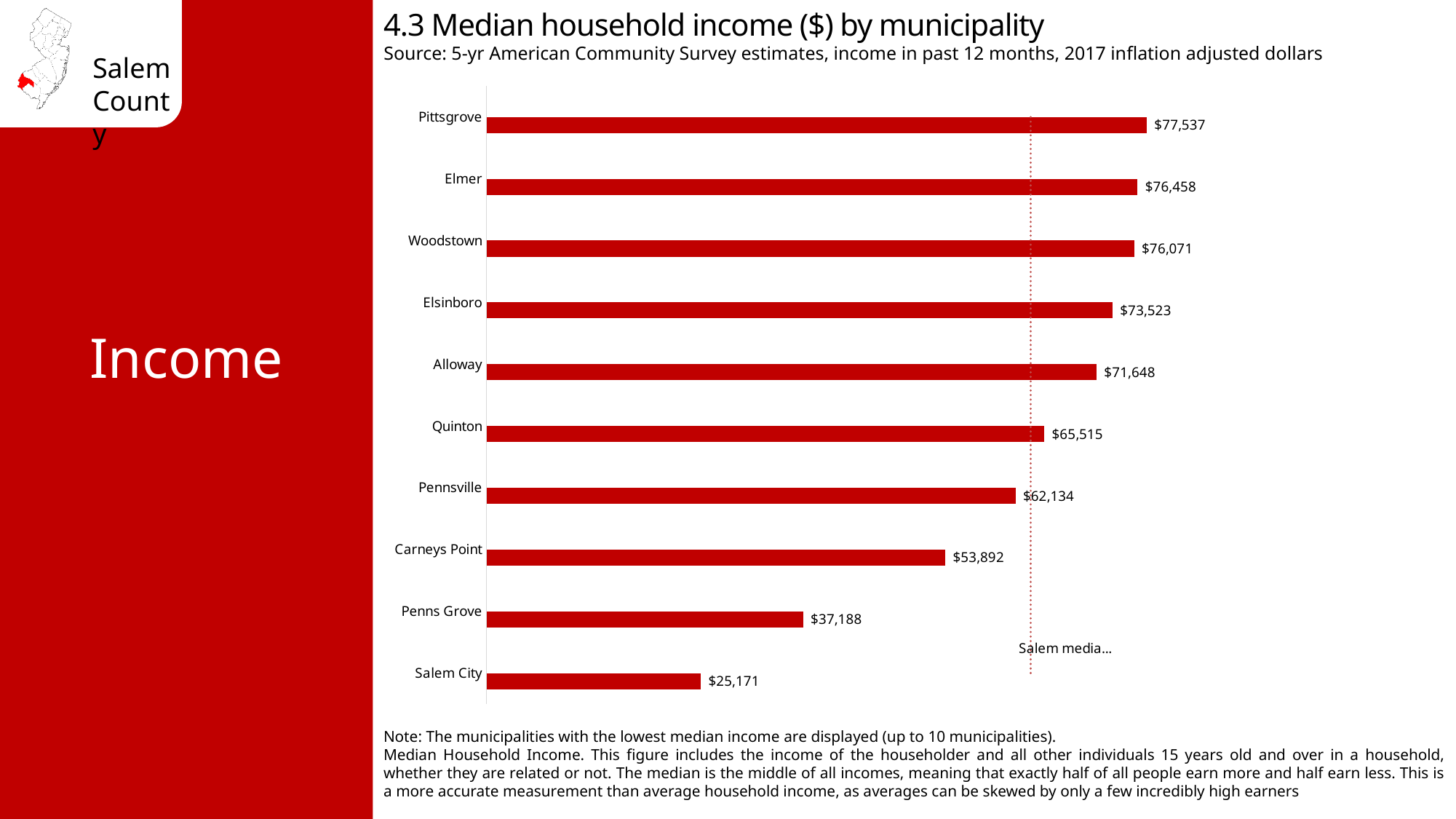
What is the difference in median household income between Pennsville and Penns Grove? $24,946 Which municipality has the highest median household income? Pittsgrove How many municipalities are shown in the chart? 10 What is the difference in median household income between Pittsgrove and Salem City? $52,366 What is the median household income for Quinton? $65,515 What kind of chart is used to show median household income by municipality? Bar chart What is the median household income for Salem City? $25,171 Which municipality has the lowest median household income? Salem City Which has a higher median household income, Elsinboro or Alloway? Elsinboro What is the median household income for Pittsgrove? $77,537 What is the title of the chart? 4.3 Median household income ($) by municipality What is the median household income for Carneys Point? $53,892